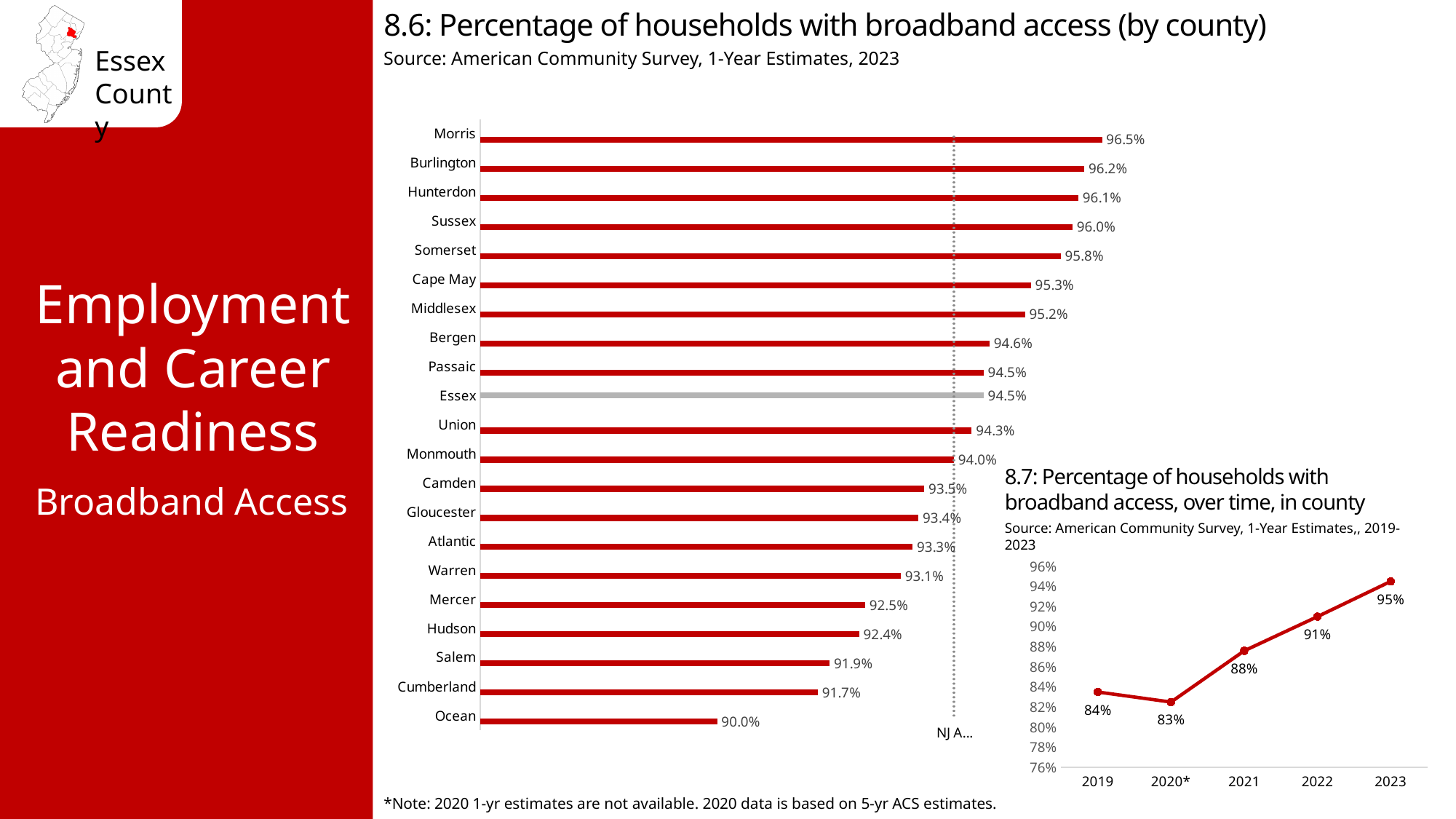
In chart 8.6, what is the difference in percentage points between Morris and Ocean? 6.5 What kind of chart is chart 8.6? Bar chart In chart 8.6, what is the value for Cumberland? 91.7% In chart 8.7, which year has the lowest value? 2020* In chart 8.6, which county has the lowest percentage of households with broadband access? Ocean In chart 8.6, which county has the highest percentage of households with broadband access? Morris In chart 8.6, what is the percentage of households with broadband access in Essex? 94.5% In chart 8.7, what is the difference in percentage points between 2023 and 2019? 11 In chart 8.6, which county has a higher value, Bergen or Hudson? Bergen In chart 8.6, how many counties are shown? 21 In chart 8.7, what was the percentage of households with broadband access in 2021? 88% In chart 8.7, do the values generally rise or fall from 2020 to 2023? Rise